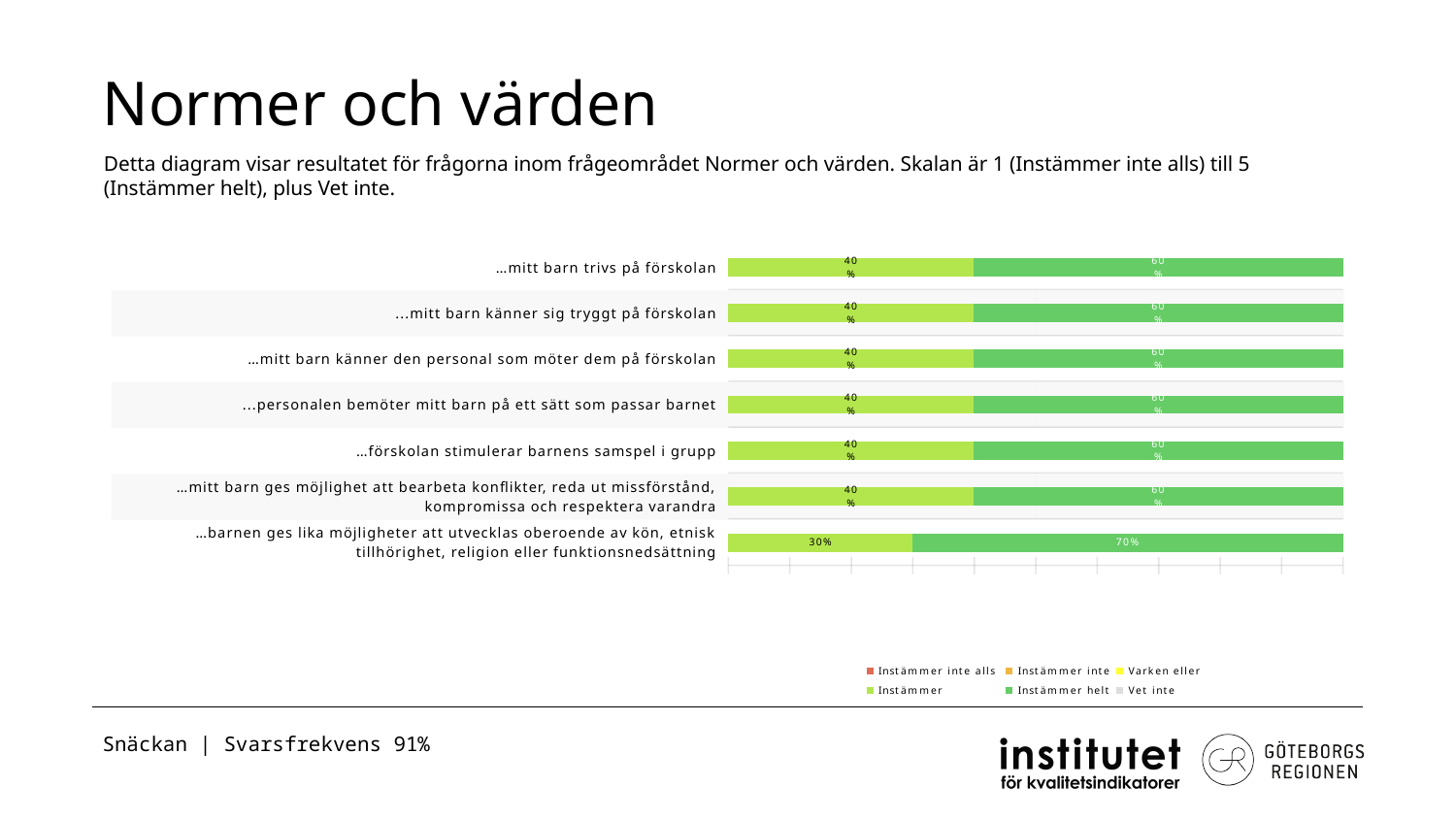
How many series does the legend list? 6 What is the value of the 'Instämmer helt' segment for '…barnen ges lika möjligheter att utvecklas oberoende av kön, etnisk tillhörighet, religion eller funktionsnedsättning'? 70% What is the difference between the 'Instämmer helt' and 'Instämmer' values for '…barnen ges lika möjligheter att utvecklas oberoende av kön, etnisk tillhörighet, religion eller funktionsnedsättning'? 40% Which statement has the highest 'Instämmer helt' value? …barnen ges lika möjligheter att utvecklas oberoende av kön, etnisk tillhörighet, religion eller funktionsnedsättning What is the total of the stacked bar for '…personalen bemöter mitt barn på ett sätt som passar barnet'? 100% What is the value of the 'Instämmer' segment for '…barnen ges lika möjligheter att utvecklas oberoende av kön, etnisk tillhörighet, religion eller funktionsnedsättning'? 30% What kind of chart is shown on the slide? stacked bar chart How many categories (statements) are plotted in the chart? 7 What is the value of the 'Instämmer helt' segment for '…mitt barn trivs på förskolan'? 60% What is the value of the 'Instämmer' segment for '…förskolan stimulerar barnens samspel i grupp'? 40% Which statement has the lowest 'Instämmer' value? …barnen ges lika möjligheter att utvecklas oberoende av kön, etnisk tillhörighet, religion eller funktionsnedsättning For '…mitt barn känner sig tryggt på förskolan', which is larger: the 'Instämmer' segment or the 'Instämmer helt' segment? Instämmer helt